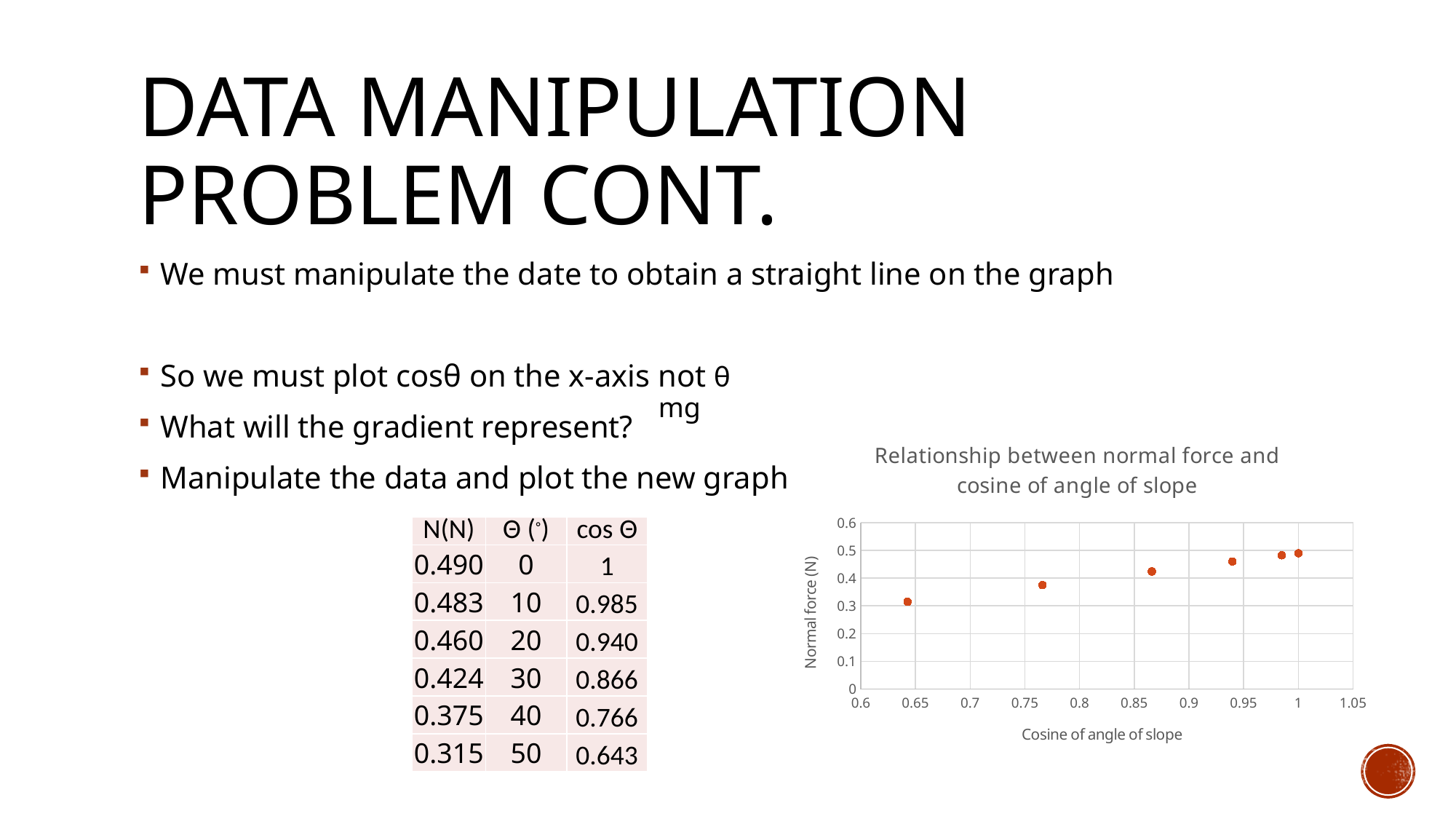
What kind of chart is shown on the slide? Scatter chart What is the title of the chart? Relationship between normal force and cosine of angle of slope Is the normal force for the point at a cosine of about 0.77 greater or less than 0.4? less Is the normal force for the point at the lowest cosine value (around 0.64) greater or less than 0.4? less What is the highest value shown on the chart's y-axis? 0.6 How many data points are plotted on the chart? 6 Which point has the lowest normal force: the one at a cosine of about 0.64 or the one at about 0.94? The one at about 0.64 Do the plotted values rise or fall as the cosine of the angle of slope increases? Rise Is the normal force for the point at a cosine of about 0.94 greater or less than 0.4? greater What is the label of the chart's y-axis? Normal force (N)